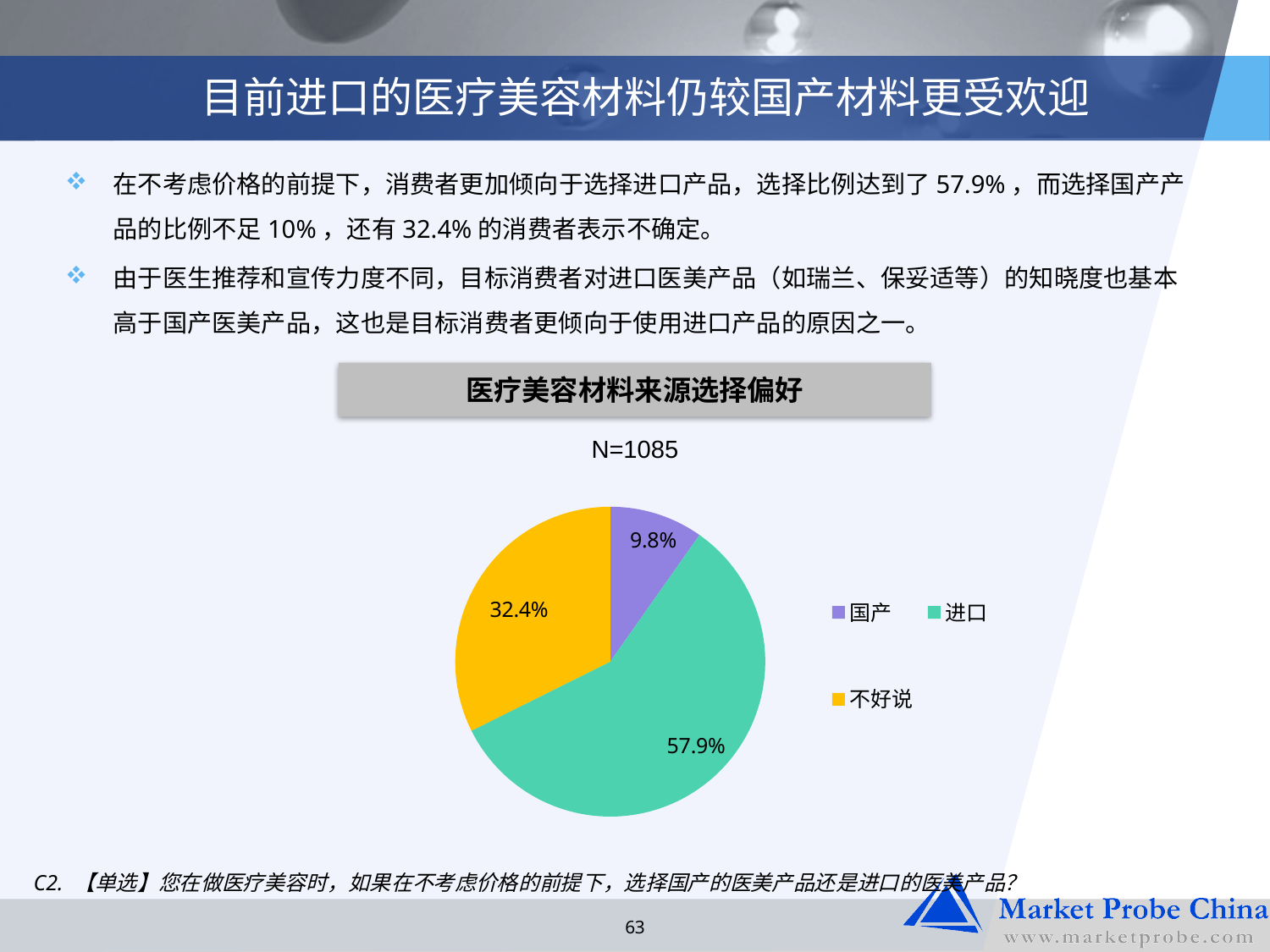
What is the title of the chart? 医疗美容材料来源选择偏好 How many entries does the legend list? 3 What is the difference between the shares for 进口 and 国产? 48.1% Which category has the largest share of the pie? 进口 Which is larger, the share for 不好说 or the share for 国产? 不好说 What is the value for 国产 in the pie chart? 9.8% What sample size (N) is shown above the pie chart? N=1085 Which category has the smallest share of the pie? 国产 How many categories does the pie chart show? 3 What is the value for 进口 in the pie chart? 57.9% What is the value for 不好说 in the pie chart? 32.4% What type of chart is shown on the slide? pie chart